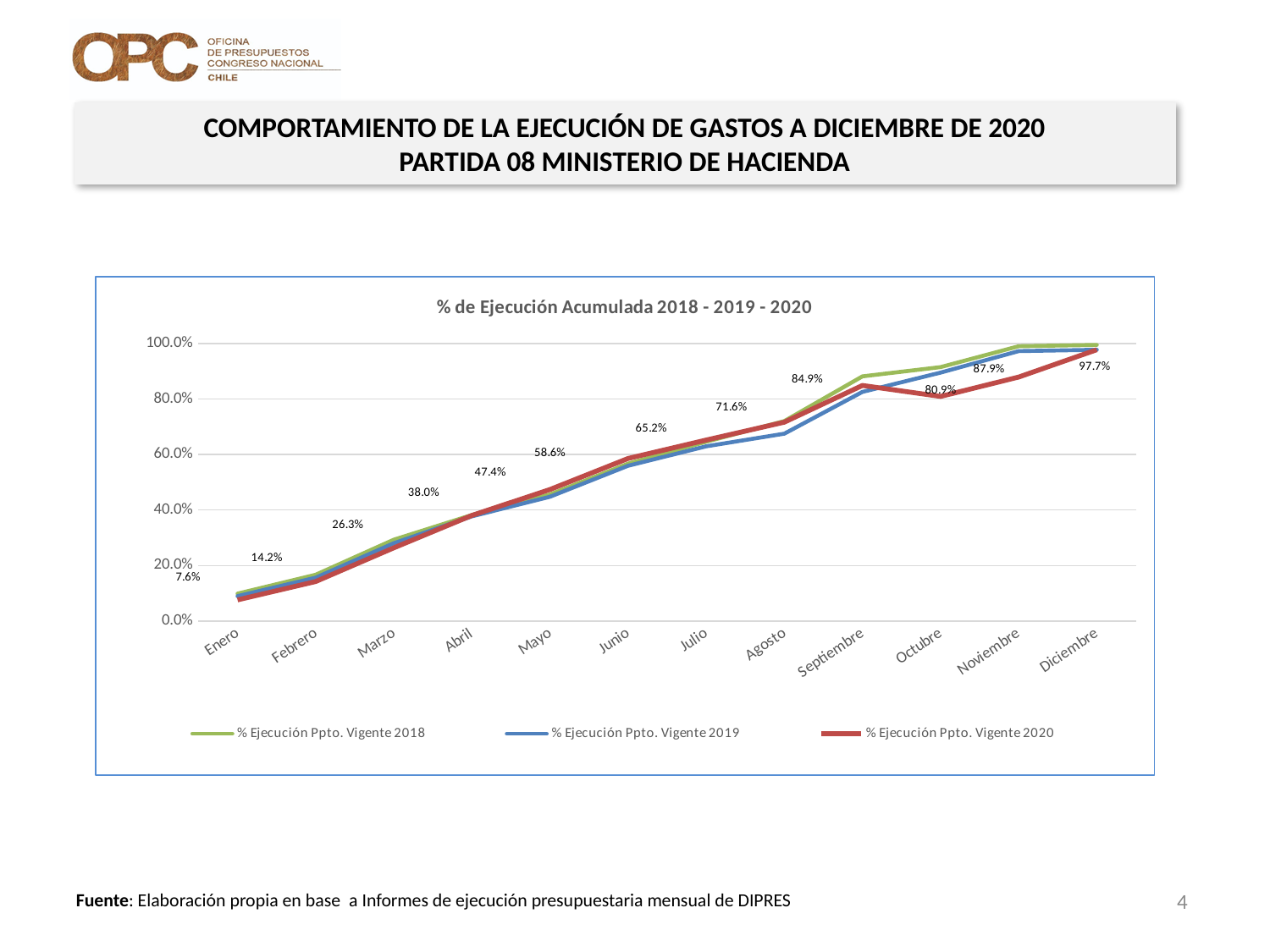
What is the title of the chart? % de Ejecución Acumulada 2018 - 2019 - 2020 What is the value of % Ejecución Ppto. Vigente 2020 for Enero? 7.6% What is the value of % Ejecución Ppto. Vigente 2020 for Diciembre? 97.7% What is the value of % Ejecución Ppto. Vigente 2020 for Octubre? 80.9% In which month does the 2020 series reach its lowest value? Enero How many series does the legend list? 3 What is the difference between the 2020 values for Diciembre and Noviembre? 9.8 percentage points Is the value of % Ejecución Ppto. Vigente 2019 for Agosto greater or less than 80%? less How many months are plotted along the x axis? 12 What kind of chart is shown on the slide? Line chart For the 2020 series, which is larger: the value for Septiembre or the value for Octubre? Septiembre What is the difference between the 2020 values for Septiembre and Agosto? 13.3 percentage points